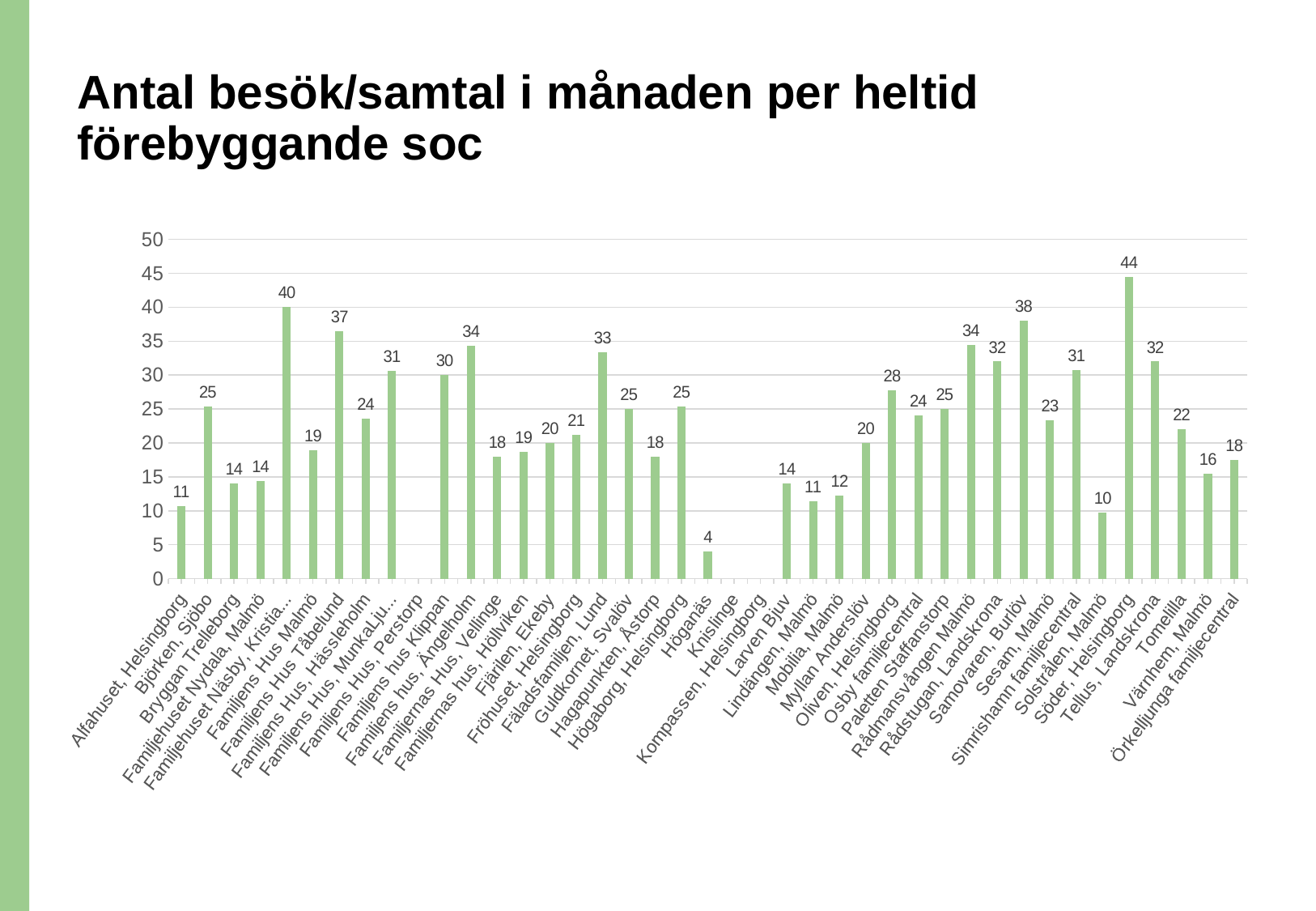
What is the value for Söder, Helsingborg? 44 What is the difference between the values for Söder, Helsingborg and Familjens Hus Tåbelund? 7 What is the title of the slide? Antal besök/samtal i månaden per heltid förebyggande soc What is the value for Familjehuset Näsby? 40 Which category has the highest value? Söder, Helsingborg What kind of chart is shown on the slide? Bar chart What is the value for Samovaren, Burlöv? 38 Which category with a bar has the lowest value? Höganäs Which is larger, the value for Oliven, Helsingborg or the value for Sesam, Malmö? Oliven, Helsingborg What is the value for Tellus, Landskrona? 32 What is the value for Höganäs? 4 Is the value for Rådmansvången Malmö greater or less than 30? greater